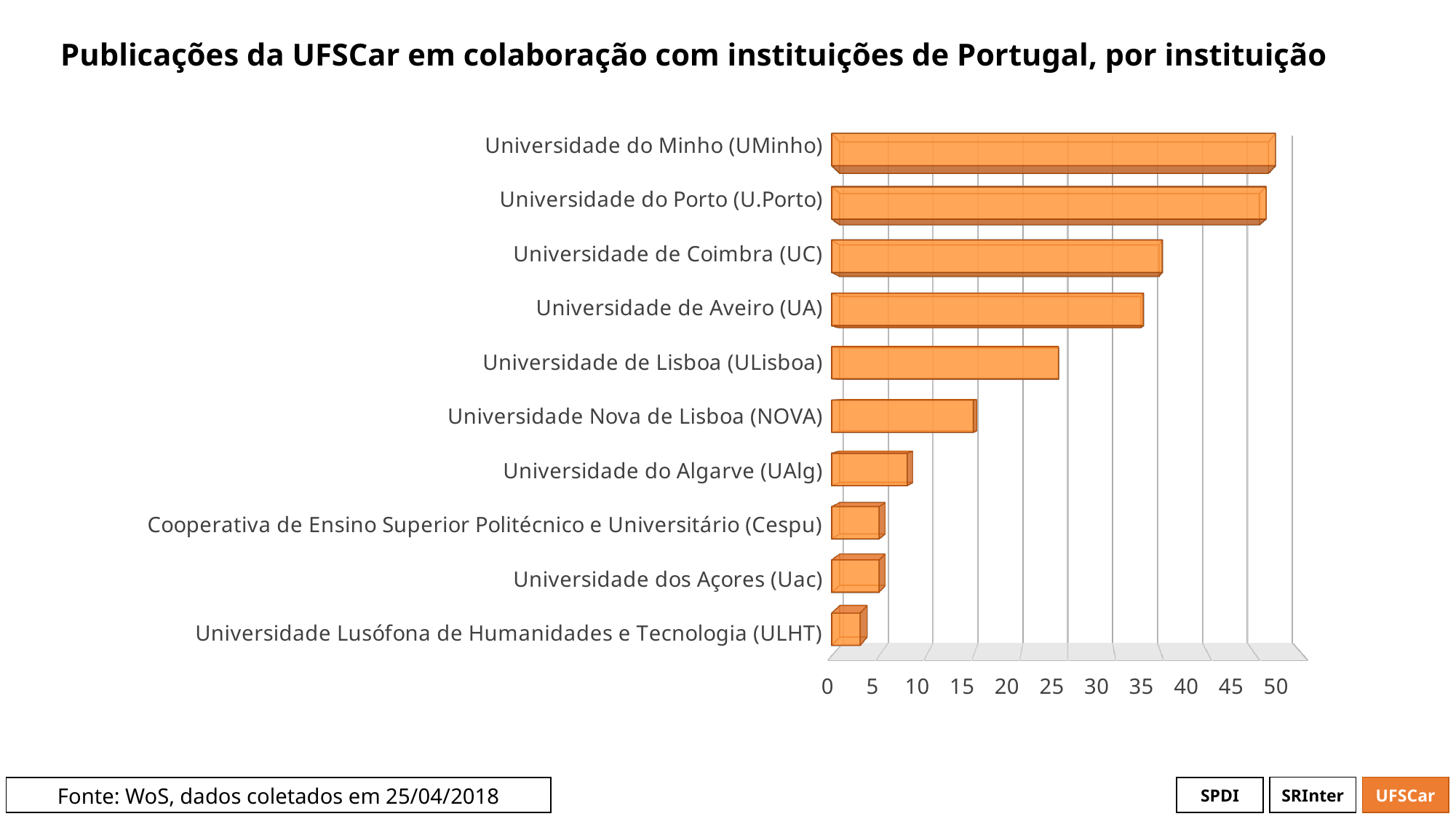
What is the title of the chart? Publicações da UFSCar em colaboração com instituições de Portugal, por instituição How many institutions are listed in the chart? 10 Which has more publications with UFSCar: Universidade Nova de Lisboa (NOVA) or Universidade do Algarve (UAlg)? Universidade Nova de Lisboa (NOVA) Is the value for Universidade de Coimbra (UC) greater or less than 30? greater Is the value for Universidade Nova de Lisboa (NOVA) greater or less than 20? less Which institution has the lowest number of publications in collaboration with UFSCar? Universidade Lusófona de Humanidades e Tecnologia (ULHT) Is the value for Universidade do Algarve (UAlg) greater or less than 15? less What kind of chart is shown on the slide? bar chart Which has more publications with UFSCar: Universidade de Aveiro (UA) or Universidade de Lisboa (ULisboa)? Universidade de Aveiro (UA)